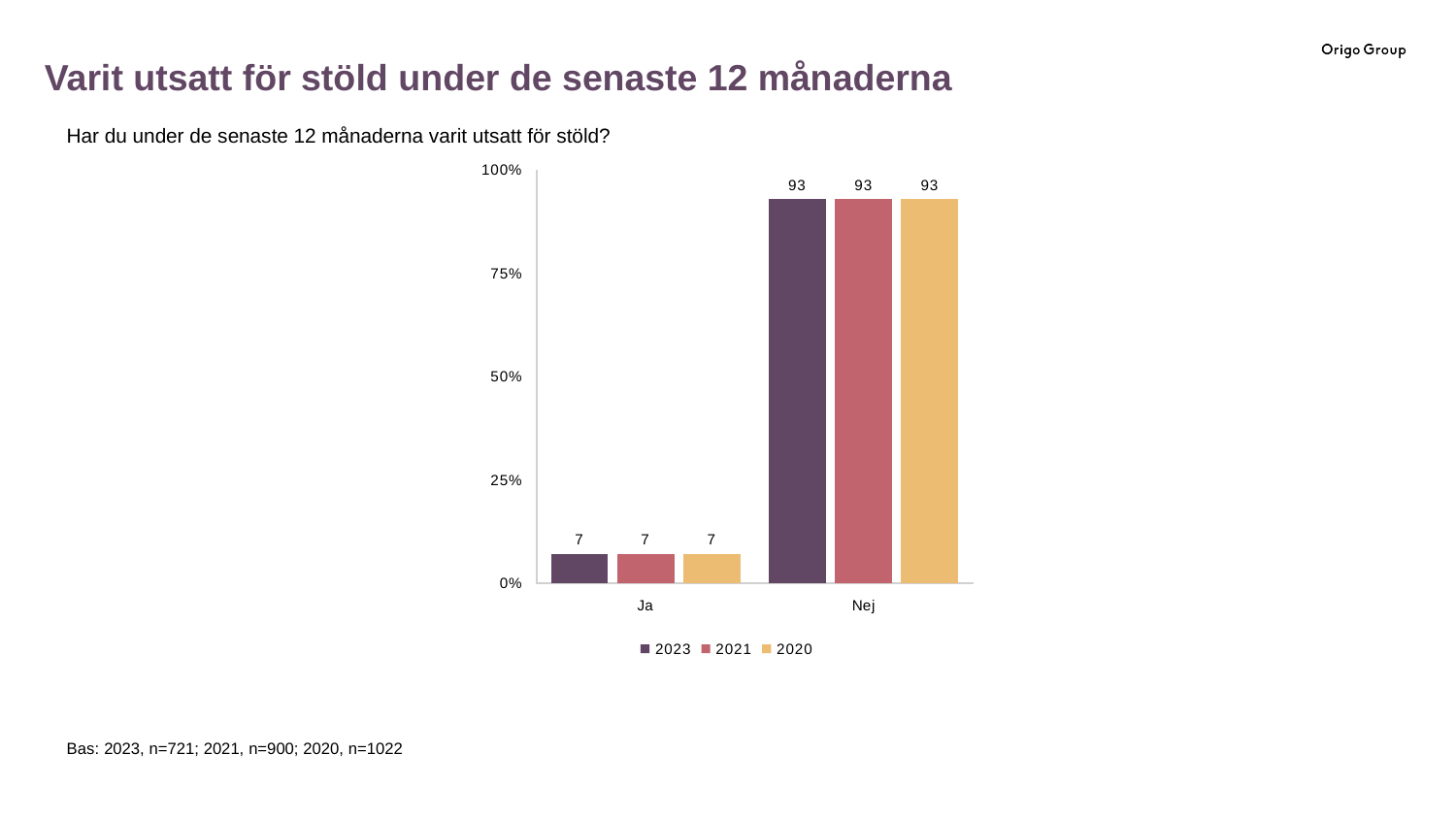
How many series does the legend list? 3 What is the value for 'Nej' in the 2021 series? 93 What is the value for 'Nej' in the 2020 series? 93 What is the value for 'Ja' in the 2023 series? 7 How many categories are shown on the x axis? 2 Which category has the highest value in the 2023 series? Nej What is the value for 'Ja' in the 2020 series? 7 Is the value for 'Nej' in the 2023 series greater or less than 75%? greater What is the difference between the 'Nej' and 'Ja' values in the 2023 series? 86 Which category has the lowest value in the 2021 series? Ja What kind of chart is shown on the slide? bar chart Which is larger in the 2020 series: the value for 'Ja' or the value for 'Nej'? Nej